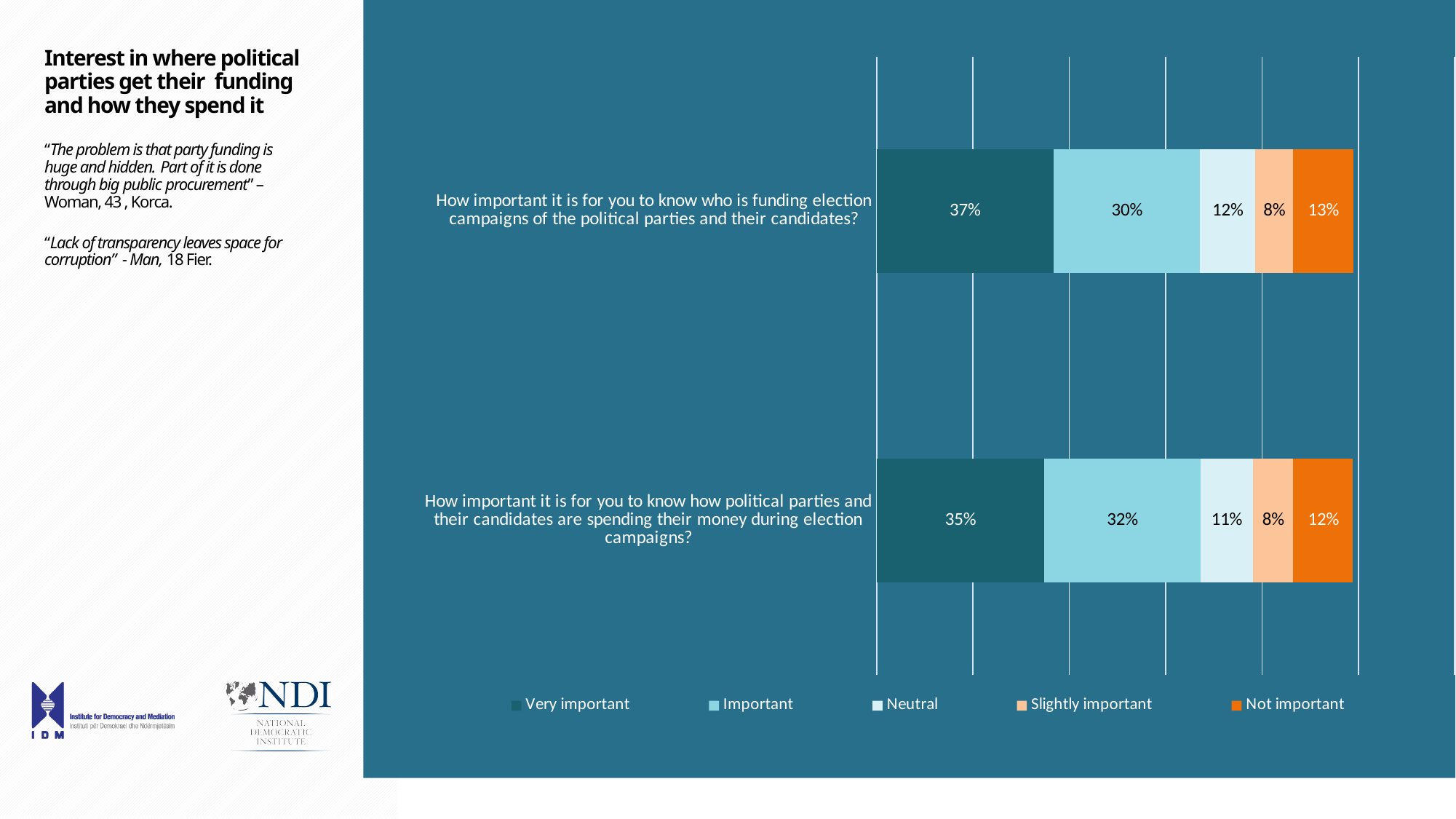
What percentage of respondents answered "Neutral" for knowing how political parties and their candidates are spending their money during election campaigns? 11% Which legend entry is shown in orange? Not important What percentage of respondents said it is "Important" to know how political parties and their candidates are spending their money during election campaigns? 32% How many series does the legend list? 5 How many survey questions (bars) are shown in the chart? 2 Is the "Important" share larger for the question about who is funding election campaigns or for the question about how parties are spending their money? How parties are spending their money Which response category has the largest share for the question about knowing who is funding election campaigns? Very important Which response category has the smallest share for the question about knowing how political parties are spending their money during election campaigns? Slightly important What percentage of respondents said it is "Very important" to know who is funding election campaigns of the political parties and their candidates? 37% What percentage of respondents answered "Not important" for knowing who is funding election campaigns? 13% What is the difference between the "Very important" shares for the funding question (37%) and the spending question (35%)? 2% What kind of chart is shown on the slide? Stacked bar chart